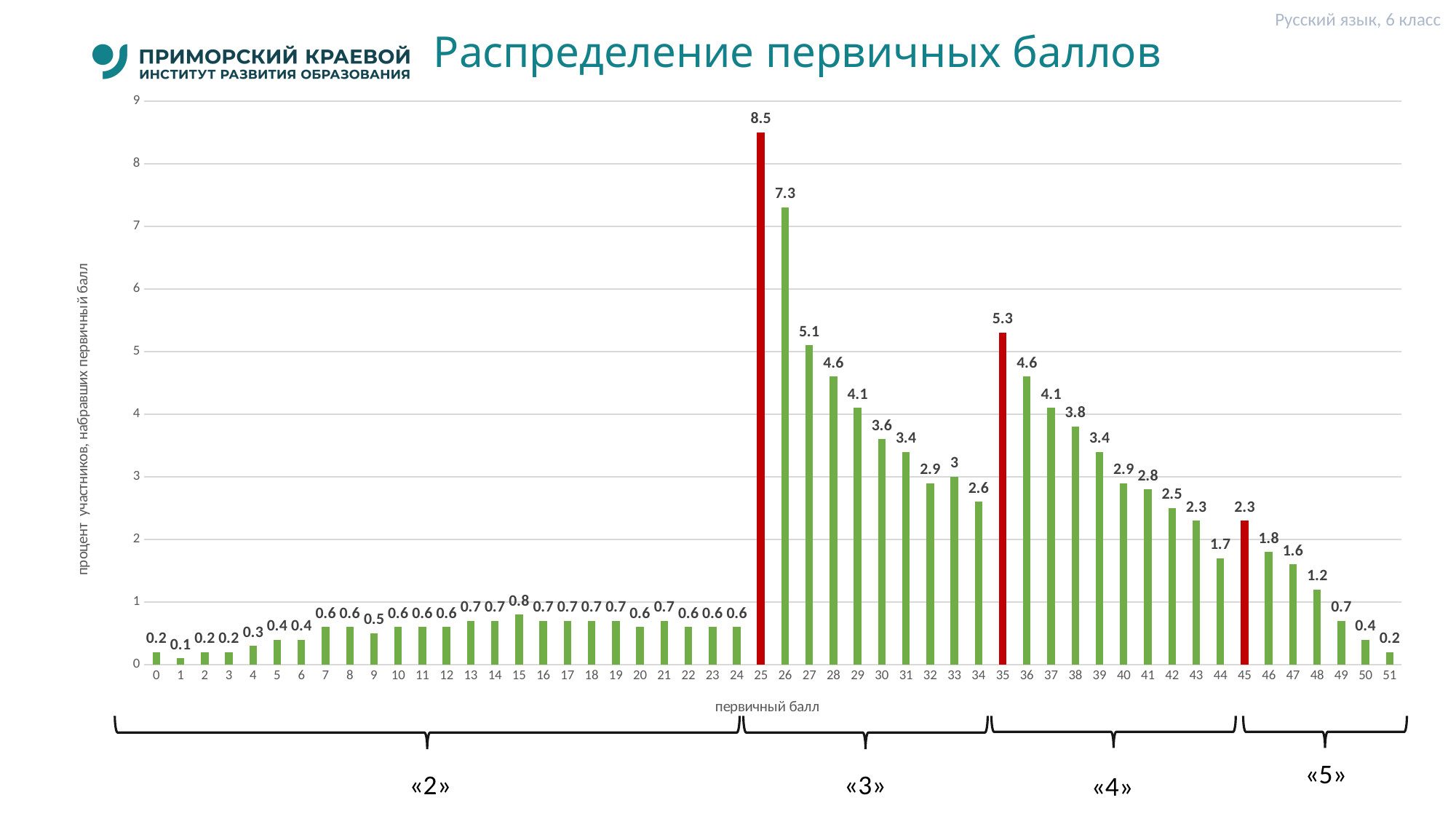
Which is larger, the value for primary score 36 or the value for primary score 40? 36 What type of chart is shown on the slide? bar chart Which primary scores are shown with red bars? 25, 35 and 45 What is the value for primary score 35? 5.3 What is the value for primary score 25? 8.5 What is the value for primary score 45? 2.3 What is the title of the chart? Распределение первичных баллов What is the difference between the values for primary scores 25 and 26? 1.2 Which primary score has the lowest percentage of participants? 1 Which primary score has the highest percentage of participants? 25 How many primary score categories are shown on the x axis? 52 What is the value for primary score 15? 0.8